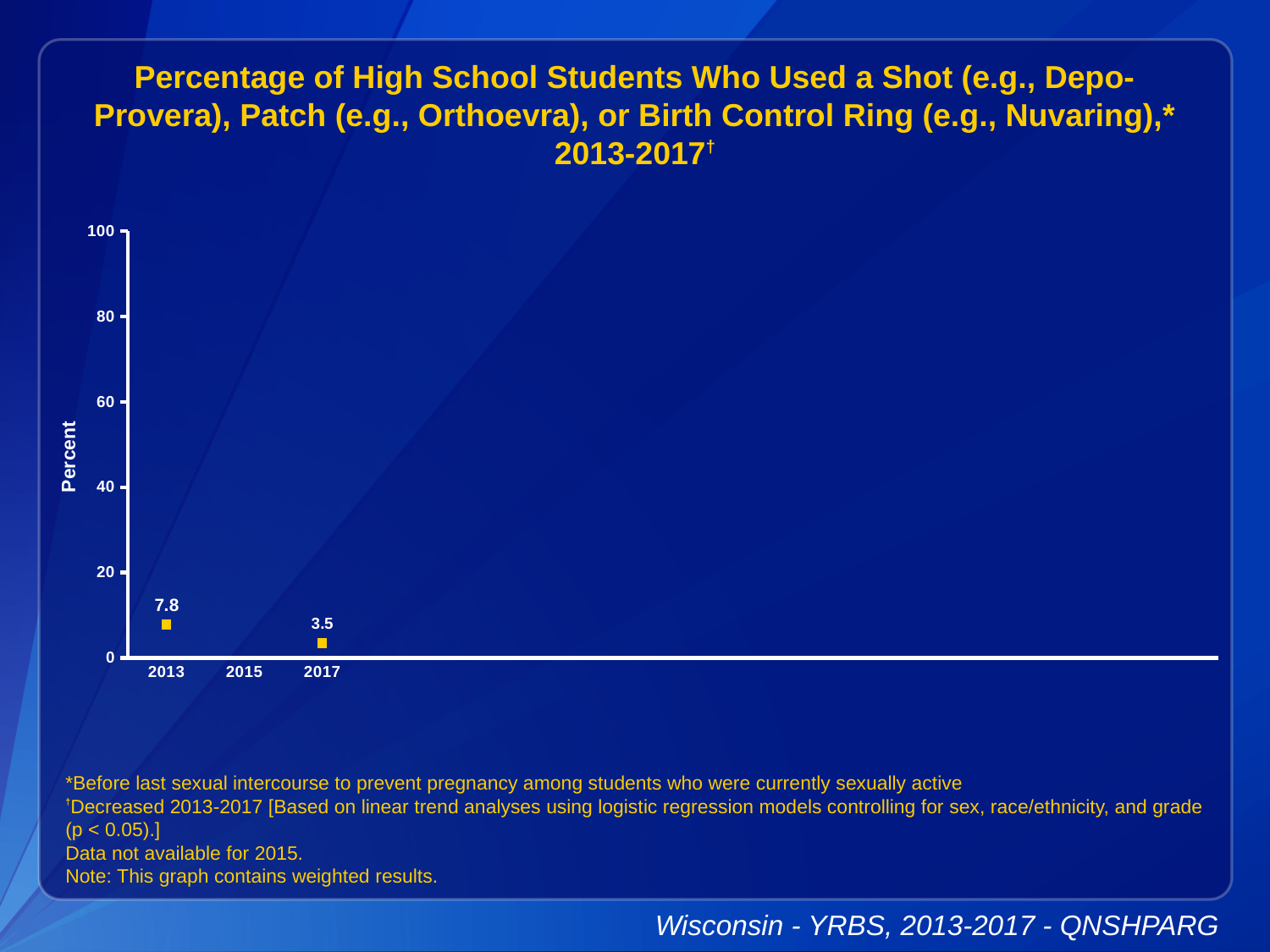
For which year is data not available? 2015 Which is larger, the value for 2013 or the value for 2017? 2013 How many data points are plotted on the chart? 2 What is the difference between the values for 2013 and 2017? 4.3 Which year has the lowest plotted value? 2017 What is the label of the y axis? Percent Which year has the highest value? 2013 How many years are labeled on the x axis? 3 Do the plotted values rise or fall from 2013 to 2017? fall What is the value for 2017? 3.5 Is the value for 2013 greater or less than 20? less What is the value for 2013? 7.8